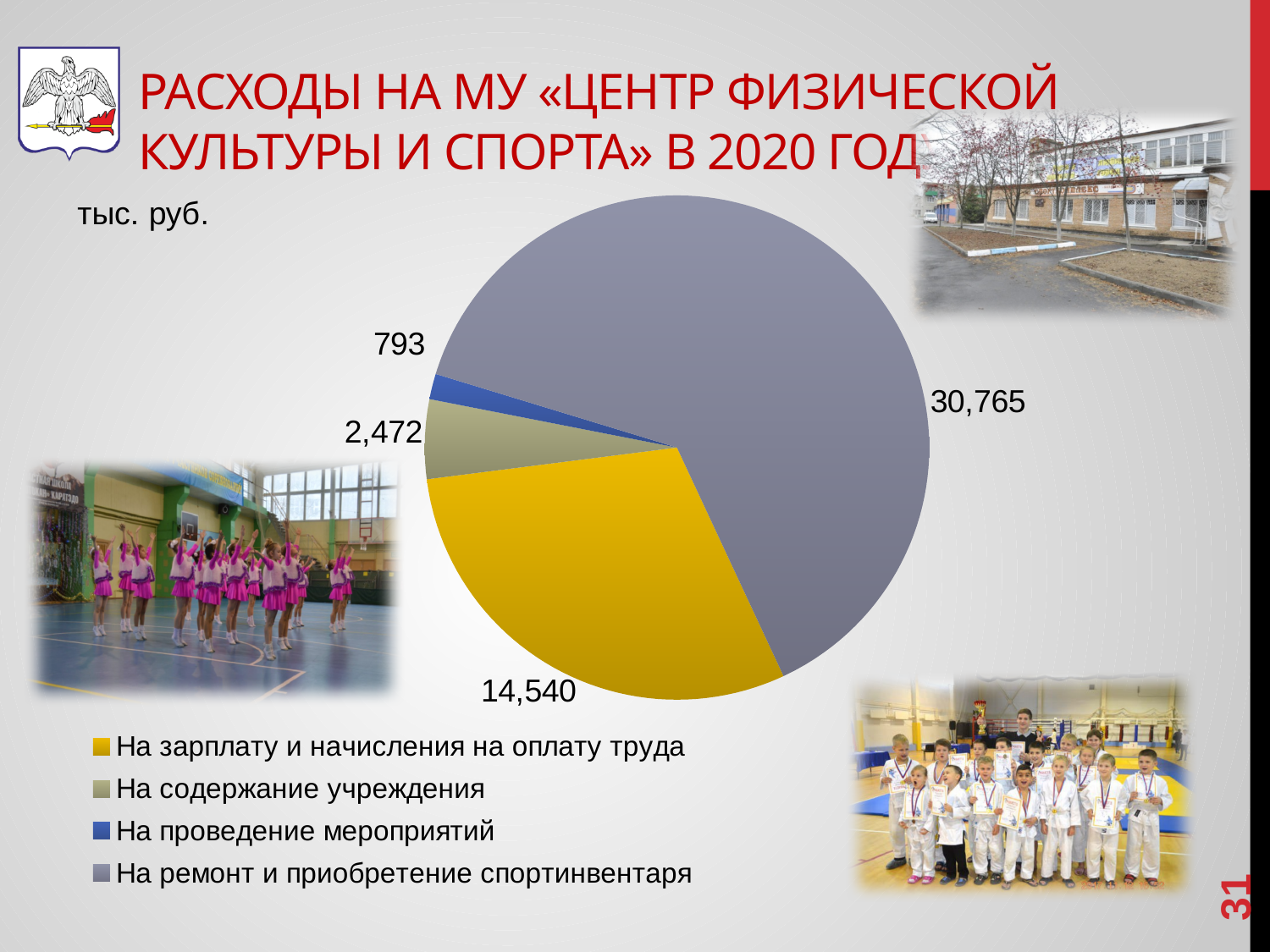
What is the value for «На зарплату и начисления на оплату труда»? 14,540 What kind of chart is shown on the slide? pie chart How many categories does the pie chart show? 4 What unit of measurement is indicated for the chart values? тыс. руб. What is the value for «На проведение мероприятий»? 793 What is the difference between the values for «На ремонт и приобретение спортинвентаря» and «На зарплату и начисления на оплату труда»? 16,225 What is the value for «На ремонт и приобретение спортинвентаря»? 30,765 What is the value for «На содержание учреждения»? 2,472 Which category has the smallest slice of the pie? На проведение мероприятий What is the total of all slices in the pie chart? 48,570 Which category has the largest slice of the pie? На ремонт и приобретение спортинвентаря Which is larger: the value for «На содержание учреждения» or for «На проведение мероприятий»? На содержание учреждения